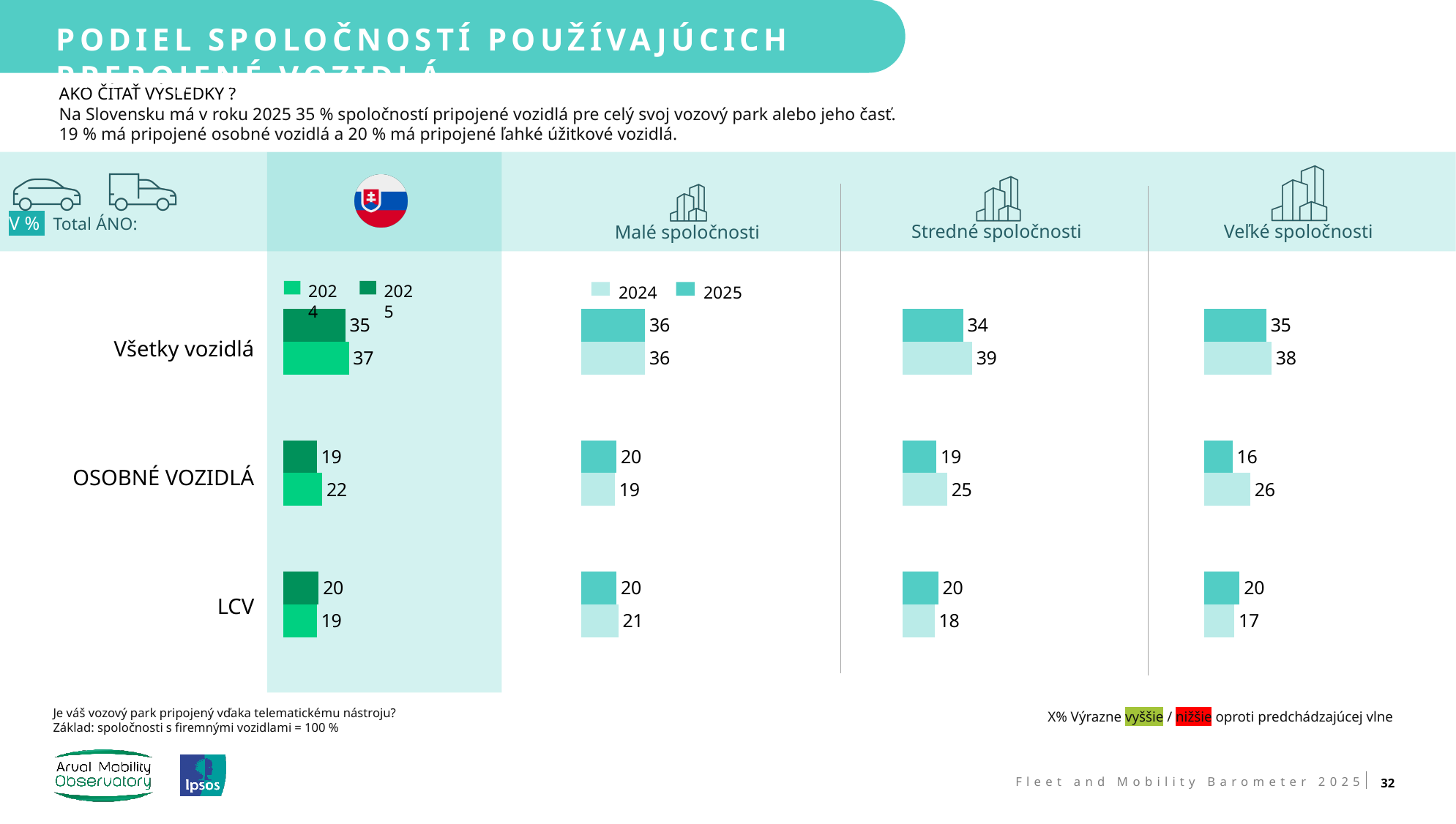
In the Stredné spoločnosti chart, what is the 2024 value for Všetky vozidlá? 39 In the Veľké spoločnosti chart, what is the 2024 value for OSOBNÉ VOZIDLÁ? 26 How many categories are shown in the Stredné spoločnosti chart? 3 In the Malé spoločnosti chart, which category has the highest 2025 value? Všetky vozidlá In the Veľké spoločnosti chart, what is the difference between the 2024 and 2025 values for OSOBNÉ VOZIDLÁ? 10 In the Slovakia (flag) chart, is the 2024 value for LCV larger or smaller than the 2025 value for LCV? smaller In the Stredné spoločnosti chart, what is the difference between the 2024 and 2025 values for OSOBNÉ VOZIDLÁ? 6 In the Slovakia (flag) chart, what is the 2024 value for OSOBNÉ VOZIDLÁ? 22 In the Veľké spoločnosti chart, which category has the lowest 2025 value? OSOBNÉ VOZIDLÁ What kind of chart is used in the Veľké spoločnosti panel? bar chart In the Slovakia (flag) chart, what is the 2025 value for Všetky vozidlá? 35 How many series does the legend of the Malé spoločnosti chart list? 2